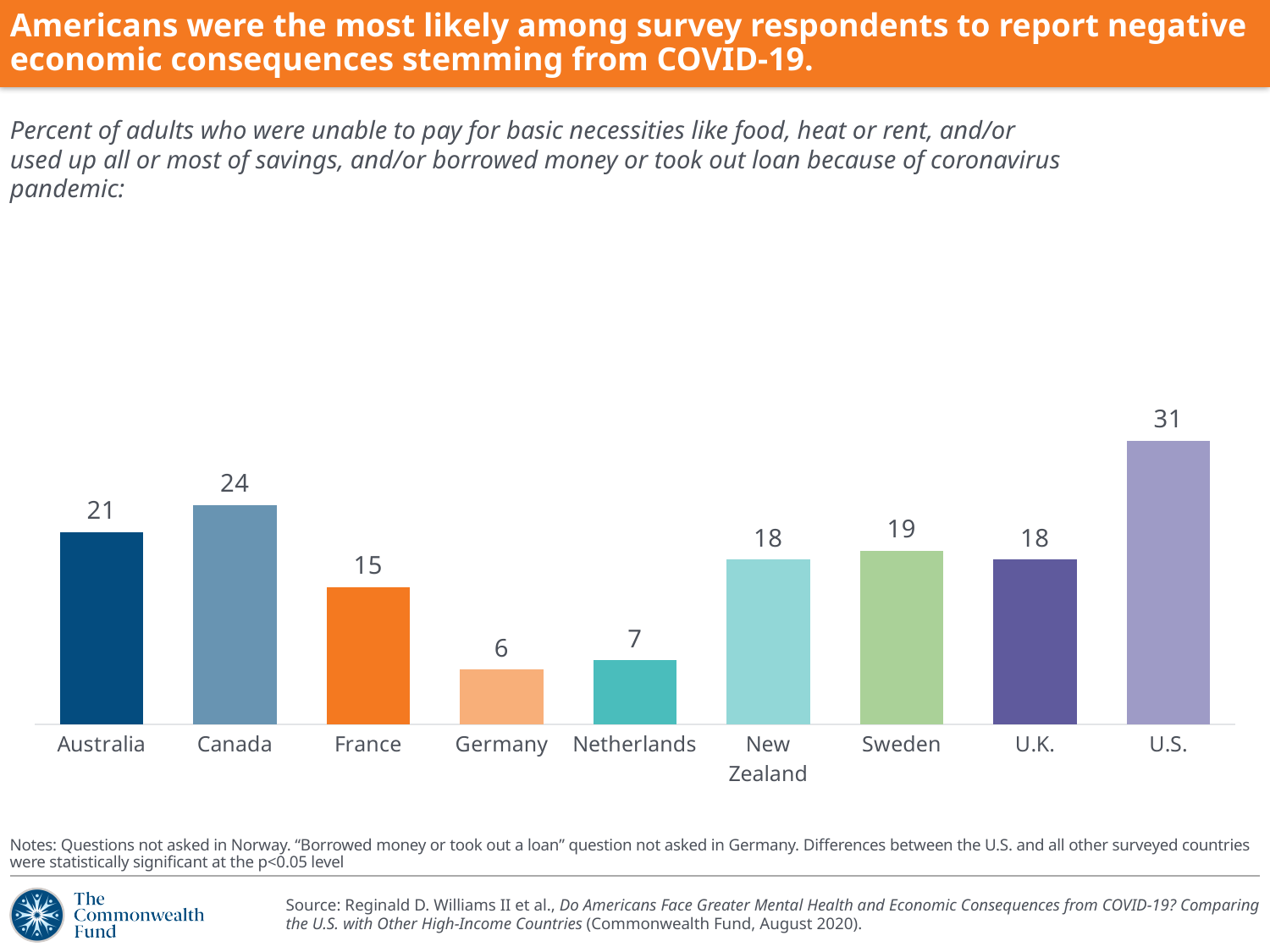
Which country has the highest value? U.S. How many countries are shown in the chart? 9 What is the value for New Zealand? 18 Which two countries share the same value of 18? New Zealand and U.K. Which country has the lowest value? Germany What is the difference between the values for the U.S. and Canada? 7 What is the value for Germany? 6 What kind of chart is shown on the slide? Bar chart Which is larger, the value for Sweden or the value for France? Sweden What is the difference between the values for Australia and France? 6 What is the value for the U.S.? 31 What is the value for Canada? 24